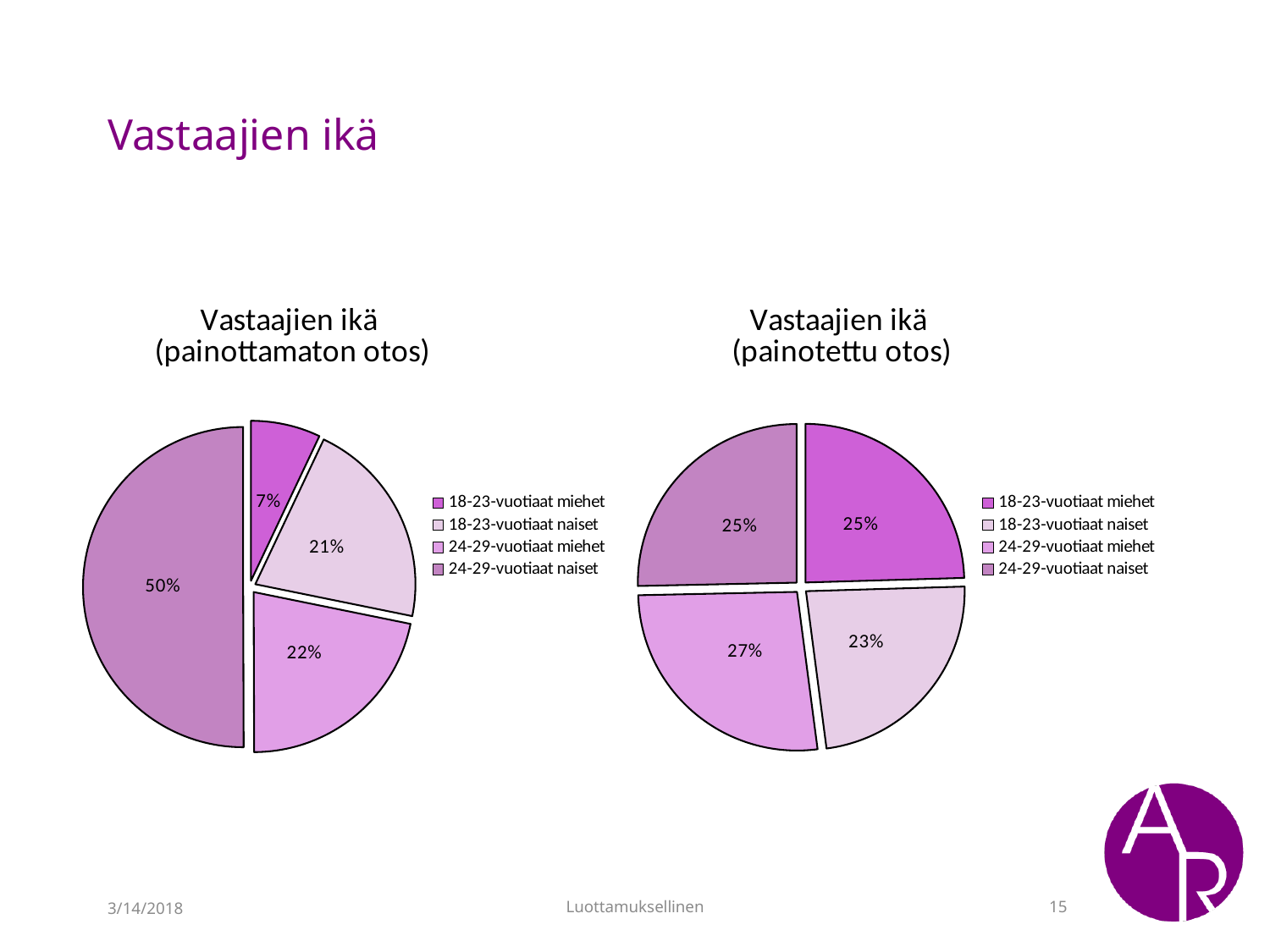
In the chart titled "Vastaajien ikä (painotettu otos)", which category has the smallest slice? 18-23-vuotiaat naiset In the chart titled "Vastaajien ikä (painottamaton otos)", what is the difference between the shares of 24-29-vuotiaat naiset and 18-23-vuotiaat miehet? 43% What type of chart is the chart titled "Vastaajien ikä (painottamaton otos)"? Pie chart In the chart titled "Vastaajien ikä (painotettu otos)", which category has the largest slice? 24-29-vuotiaat miehet In the chart titled "Vastaajien ikä (painottamaton otos)", what share do 18-23-vuotiaat miehet have? 7% How many categories does the legend of the chart titled "Vastaajien ikä (painotettu otos)" list? 4 How many charts are shown on the slide? 2 In the chart titled "Vastaajien ikä (painottamaton otos)", which is larger: the share of 18-23-vuotiaat naiset or 24-29-vuotiaat miehet? 24-29-vuotiaat miehet In the chart titled "Vastaajien ikä (painotettu otos)", what share do 24-29-vuotiaat miehet have? 27% In the chart titled "Vastaajien ikä (painottamaton otos)", which category has the smallest slice? 18-23-vuotiaat miehet In the chart titled "Vastaajien ikä (painottamaton otos)", what share do 24-29-vuotiaat naiset have? 50% In the chart titled "Vastaajien ikä (painotettu otos)", what share do 18-23-vuotiaat naiset have? 23%